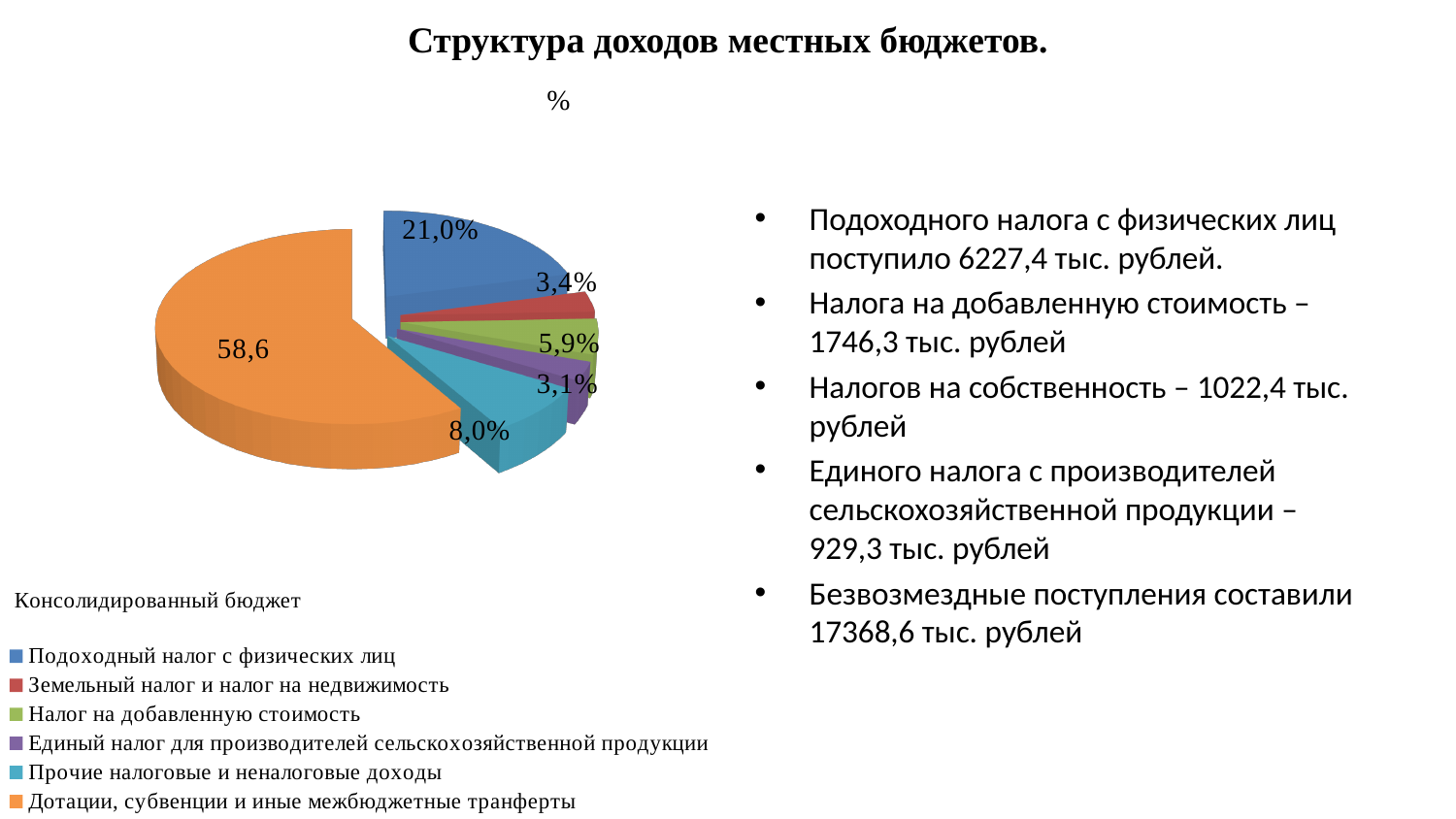
What share of the pie is labelled for Подоходный налог с физических лиц? 21,0% Which is larger: the share for Подоходный налог с физических лиц or the share for Прочие налоговые и неналоговые доходы? Подоходный налог с физических лиц What kind of chart is shown on the slide? pie chart What is the difference between the share for Подоходный налог с физических лиц and the share for Налог на добавленную стоимость? 15,1% Which category has the smallest slice of the pie? Единый налог для производителей сельскохозяйственной продукции What share is shown for Налог на добавленную стоимость? 5,9% What share is shown for Земельный налог и налог на недвижимость? 3,4% What value is shown for Дотации, субвенции и иные межбюджетные трансферты? 58,6 What share is shown for Единый налог для производителей сельскохозяйственной продукции? 3,1% Which category has the largest slice of the pie? Дотации, субвенции и иные межбюджетные трансферты How many categories does the legend list? 6 What share is shown for Прочие налоговые и неналоговые доходы? 8,0%